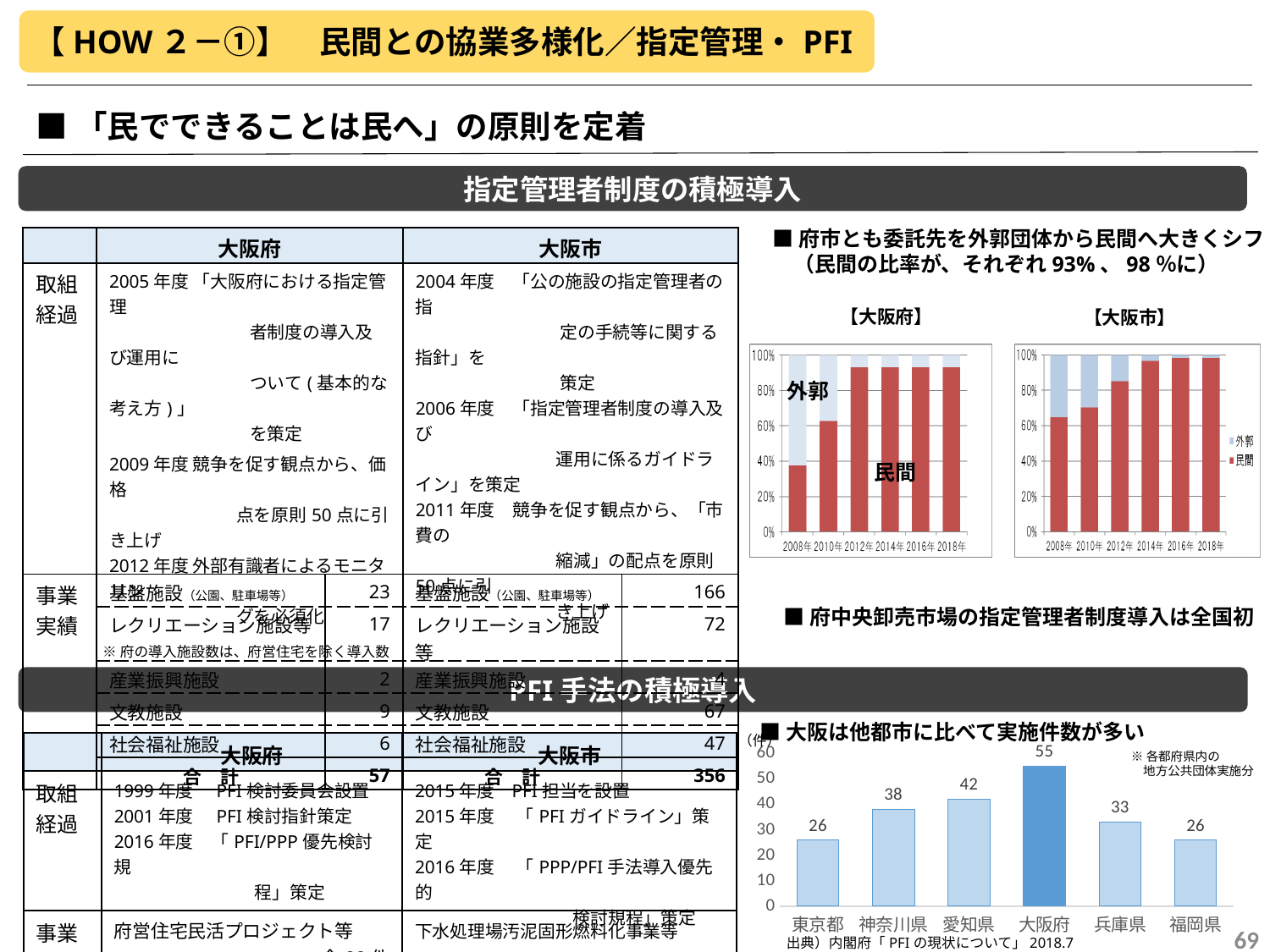
In the bottom-right bar chart of PFI implementation counts, which is larger, 神奈川県 or 兵庫県? 神奈川県 In the 【大阪市】 stacked bar chart, is the 民間 share for 2008年 greater or less than 40%? greater In the 【大阪府】 stacked bar chart, does the 民間 share rise or fall from 2008年 to 2018年? rise How many series does the legend of the 【大阪市】 stacked bar chart list? 2 In the bottom-right bar chart of PFI implementation counts, what is the difference between 神奈川県 and 東京都? 12 In the bottom-right bar chart of PFI implementation counts, which prefecture has the highest value? 大阪府 In the bottom-right bar chart of PFI implementation counts, what is the difference between 大阪府 and 愛知県? 13 In the bottom-right bar chart of PFI implementation counts, what is the value for 大阪府? 55 In the bottom-right bar chart of PFI implementation counts, what is the value for 神奈川県? 38 How many prefectures are shown in the bottom-right bar chart of PFI implementation counts? 6 In the 【大阪府】 stacked bar chart, is the 民間 share for 2012年 greater or less than 80%? greater What kind of chart is the bottom-right chart of PFI implementation counts? bar chart